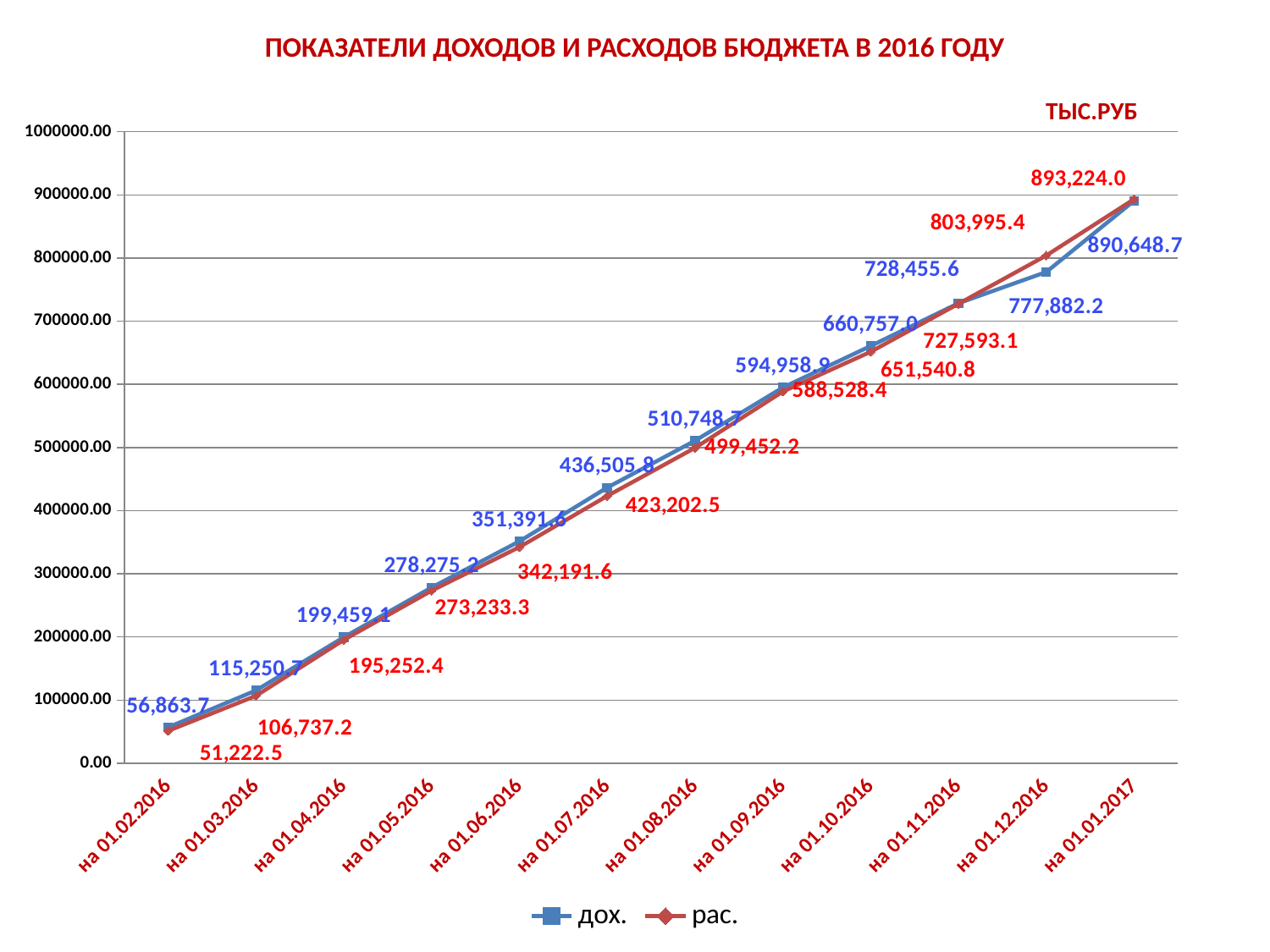
What is the value of рас. on на 01.01.2017? 893,224.0 How many series does the legend list? 2 On which date does дох. reach its highest value? на 01.01.2017 How many dates are plotted along the x axis? 12 What kind of chart is shown on the slide? line chart What is the value of дох. on на 01.12.2016? 777,882.2 On на 01.12.2016, which series has the larger value, дох. or рас.? рас. On which date is рас. at its lowest value? на 01.02.2016 What is the value of дох. on на 01.02.2016? 56,863.7 What is the value of рас. on на 01.12.2016? 803,995.4 On на 01.01.2017, how much larger is рас. than дох.? 2,575.3 Do the values of дох. rise or fall from на 01.02.2016 to на 01.01.2017? rise